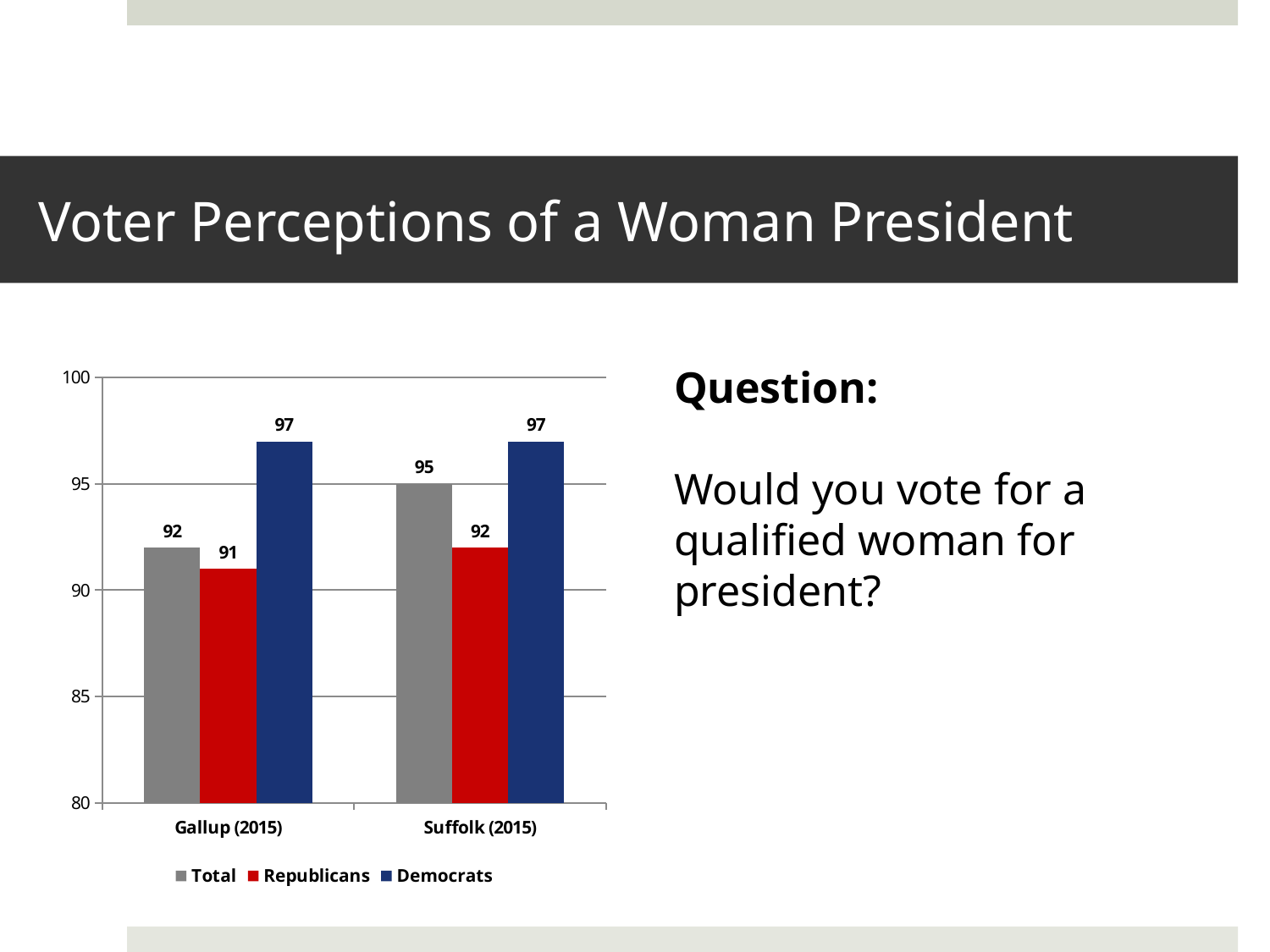
What is the difference between the Democrats and Republicans values for Gallup (2015)? 6 What is the Republicans value for Suffolk (2015)? 92 Which is larger, the Republicans value for Gallup (2015) or the Republicans value for Suffolk (2015)? Suffolk (2015) What is the difference between the Total values for Suffolk (2015) and Gallup (2015)? 3 Which series has the lowest value for Gallup (2015)? Republicans What is the Total value for Gallup (2015)? 92 How many series does the legend list? 3 What kind of chart is shown on the slide? Bar chart What is the Total value for Suffolk (2015)? 95 Which series has the highest value for Suffolk (2015)? Democrats How many categories are shown on the x axis? 2 What is the Democrats value for Gallup (2015)? 97